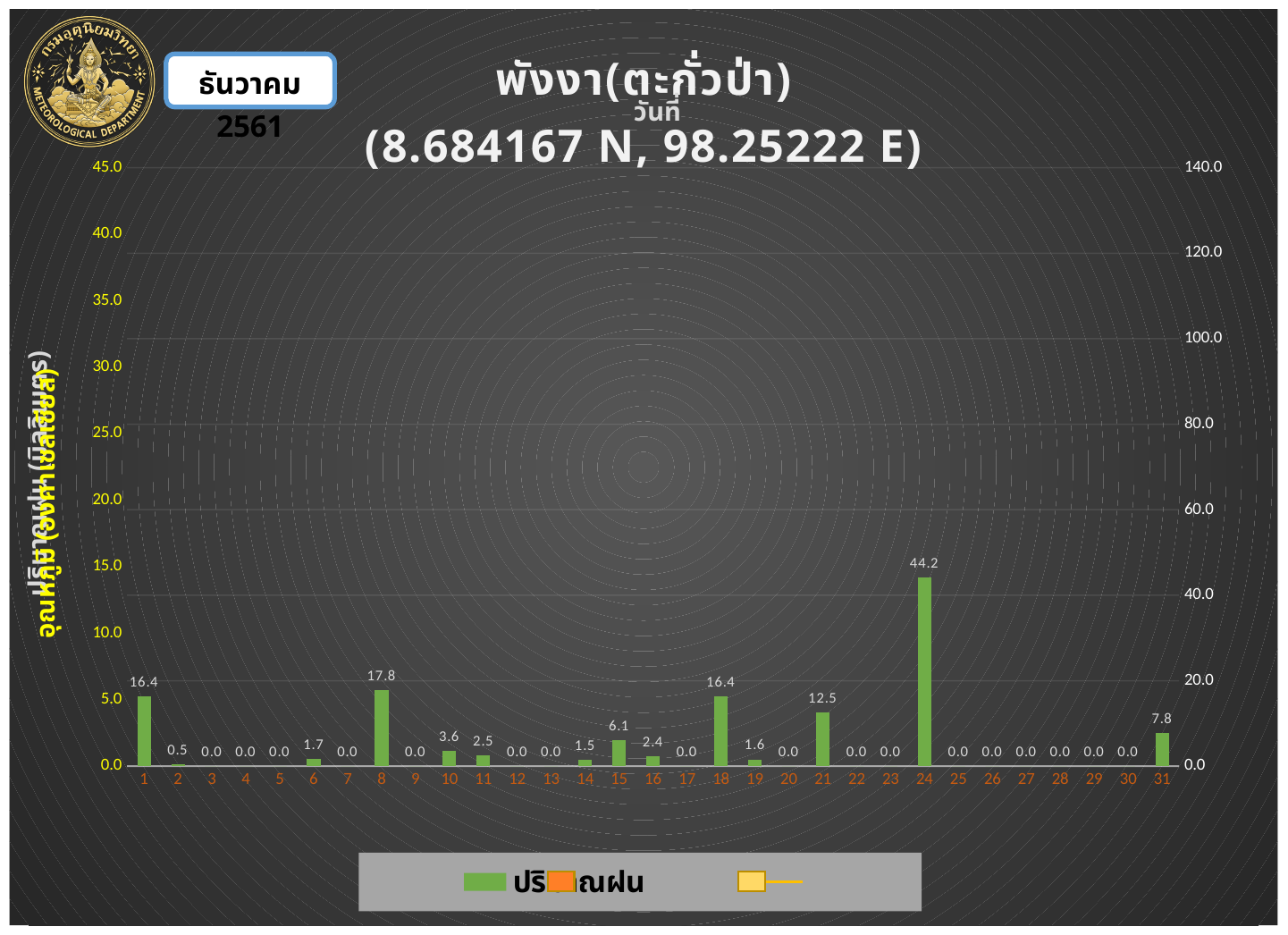
What is the value for day 24? 44.2 How many days are shown on the x axis? 31 Which day has the highest value? 24 What is the value for day 15? 6.1 What kind of chart is shown on the slide? bar chart What is the value for day 21? 12.5 Which is larger, the value for day 18 or the value for day 21? day 18 What is the value for day 31? 7.8 What is the value for day 8? 17.8 What is the difference between the values for day 24 and day 8? 26.4 Is the value for day 24 greater or less than 40.0 on the right-hand axis? greater What is the difference between the values for day 1 and day 10? 12.8